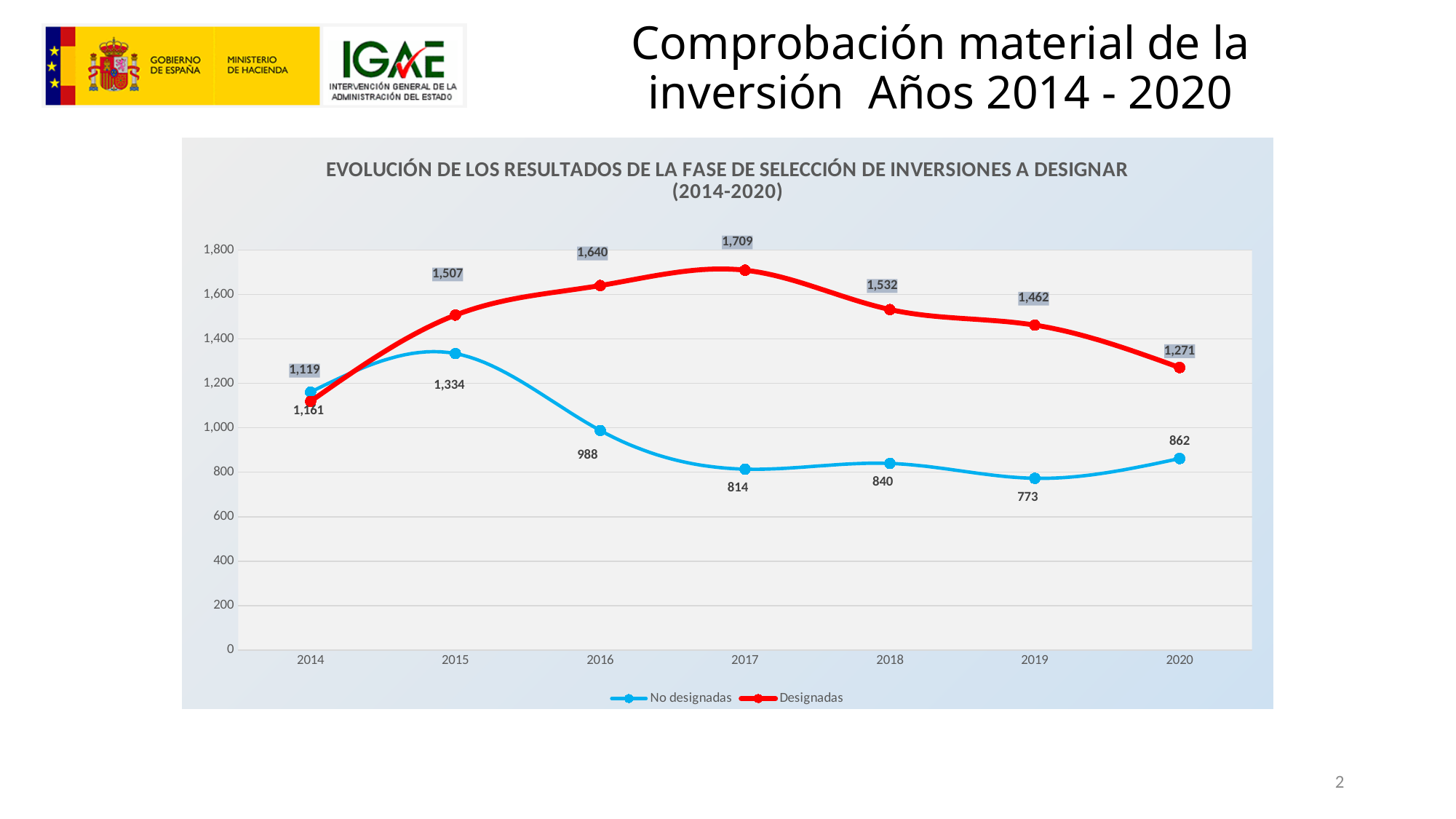
How many years are plotted on the x axis? 7 Does the Designadas series rise or fall from 2017 to 2020? Fall Which colour is used for the Designadas series? Red What is the value of Designadas in 2017? 1,709 In which year is the Designadas series highest? 2017 What type of chart is shown on the slide? Line chart In which year is the No designadas series lowest? 2019 What is the value of No designadas in 2019? 773 What is the difference between Designadas and No designadas in 2016? 652 Which series has the larger value in 2014, Designadas or No designadas? No designadas What is the value of Designadas in 2020? 1,271 How many series does the legend list? 2